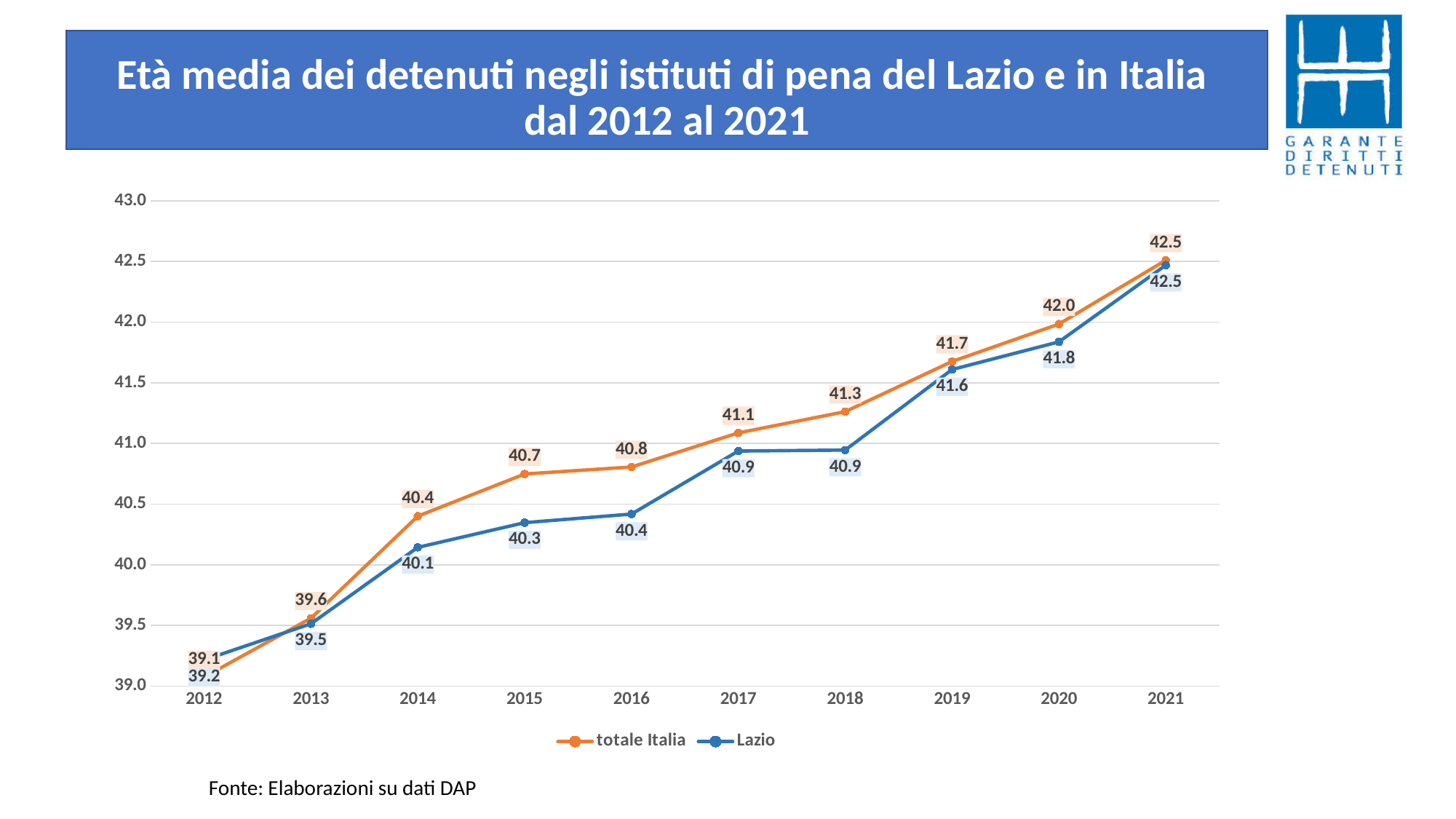
What is the difference between totale Italia and Lazio in 2015? 0.4 What is the value for Lazio in 2014? 40.1 How many series does the legend list? 2 Which is larger in 2020, totale Italia or Lazio? totale Italia Do the values for totale Italia rise or fall from 2012 to 2021? rise How many years are shown on the x axis? 10 What kind of chart is shown on the slide? line chart Is the value for Lazio in 2017 greater or less than 41.0? less What is the value for Lazio in 2019? 41.6 In which year is the Lazio series lowest? 2012 In which year is the totale Italia series highest? 2021 What is the value for totale Italia in 2016? 40.8